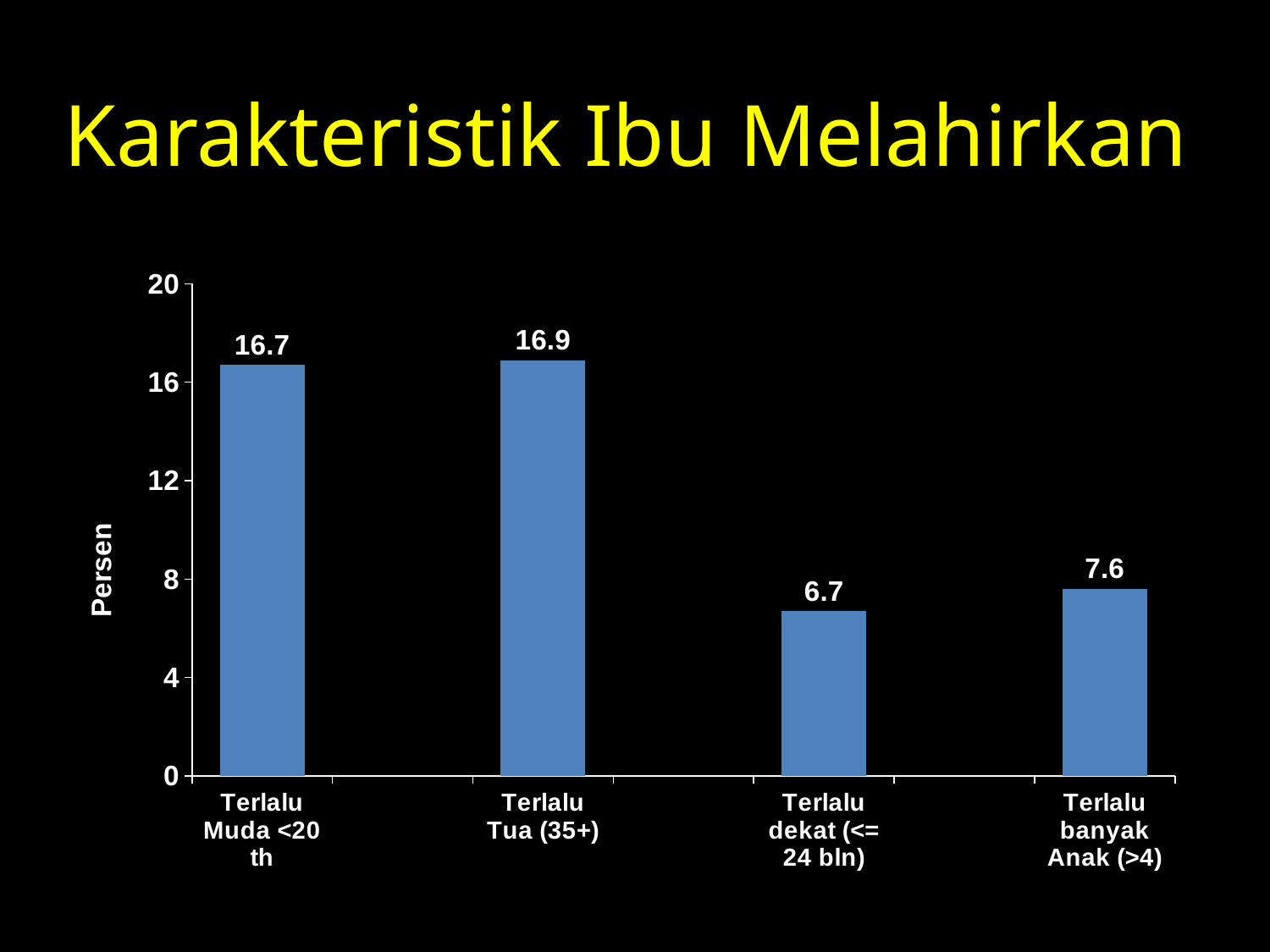
What is the value for Terlalu Muda <20 th? 16.7 How many categories are shown in the chart? 4 What is the label of the vertical axis? Persen Is the value for Terlalu Muda <20 th greater or less than 12? greater What kind of chart is shown on the slide? bar chart Which category has the highest value? Terlalu Tua (35+) Which category has the lowest value? Terlalu dekat (<= 24 bln) Which is larger, the value for Terlalu banyak Anak (>4) or Terlalu dekat (<= 24 bln)? Terlalu banyak Anak (>4) What is the value for Terlalu dekat (<= 24 bln)? 6.7 What is the value for Terlalu Tua (35+)? 16.9 What is the difference between the values for Terlalu Tua (35+) and Terlalu dekat (<= 24 bln)? 10.2 What is the value for Terlalu banyak Anak (>4)? 7.6